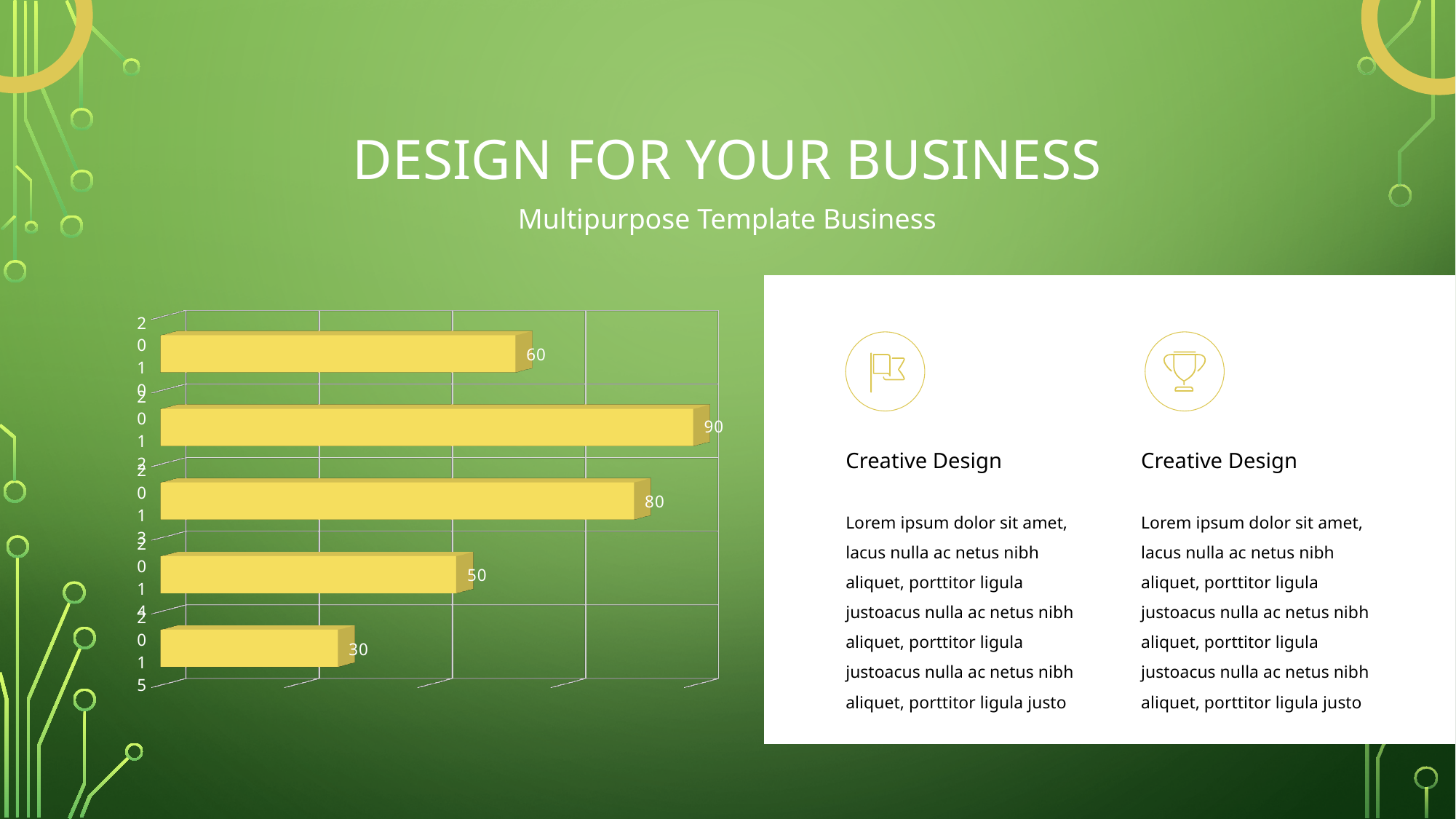
What is the value for 2015? 30 What is the value for 2012? 90 What is the value for 2014? 50 Which year has the lowest value? 2015 What is the value for 2013? 80 Which year has the highest value? 2012 How many bars does the chart have? 5 What colour are the bars in the chart? yellow What is the difference between the values for 2012 and 2015? 60 What type of chart is shown on the slide? bar chart